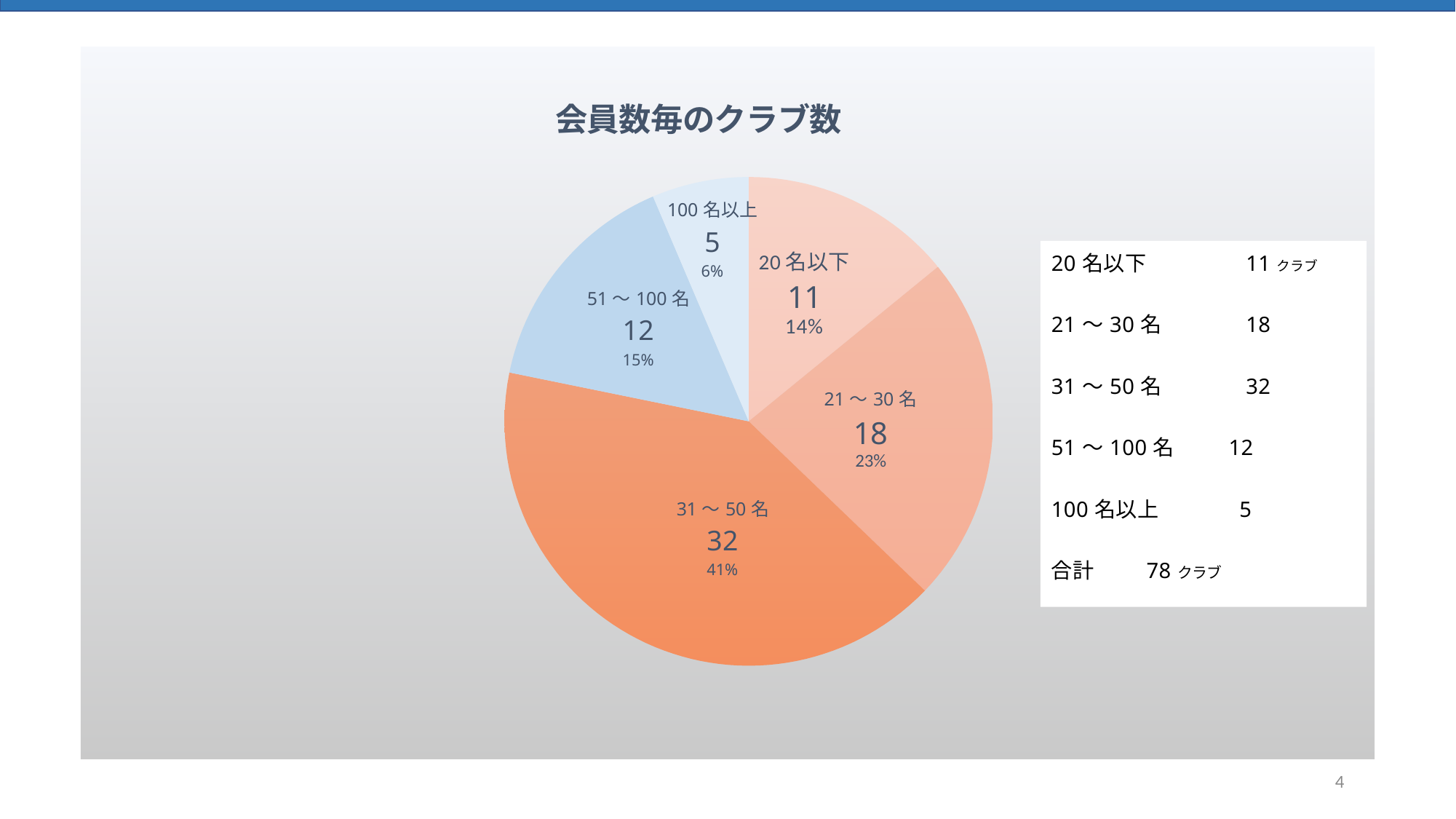
What is the title of the chart? 会員数毎のクラブ数 What is the difference in club count between 31 〜 50 名 and 21 〜 30 名? 14 What type of chart is shown on the slide? pie chart Which has more clubs, 51 〜 100 名 or 20 名以下? 51 〜 100 名 What is the total number of clubs across all categories? 78 What percentage share does the 21 〜 30 名 slice have? 23% How many clubs are in the 31 〜 50 名 category? 32 How many clubs are in the 20 名以下 category? 11 Which category has the largest number of clubs? 31 〜 50 名 How many categories does the pie chart have? 5 Which category has the smallest number of clubs? 100 名以上 What percentage share does the 100 名以上 slice have? 6%